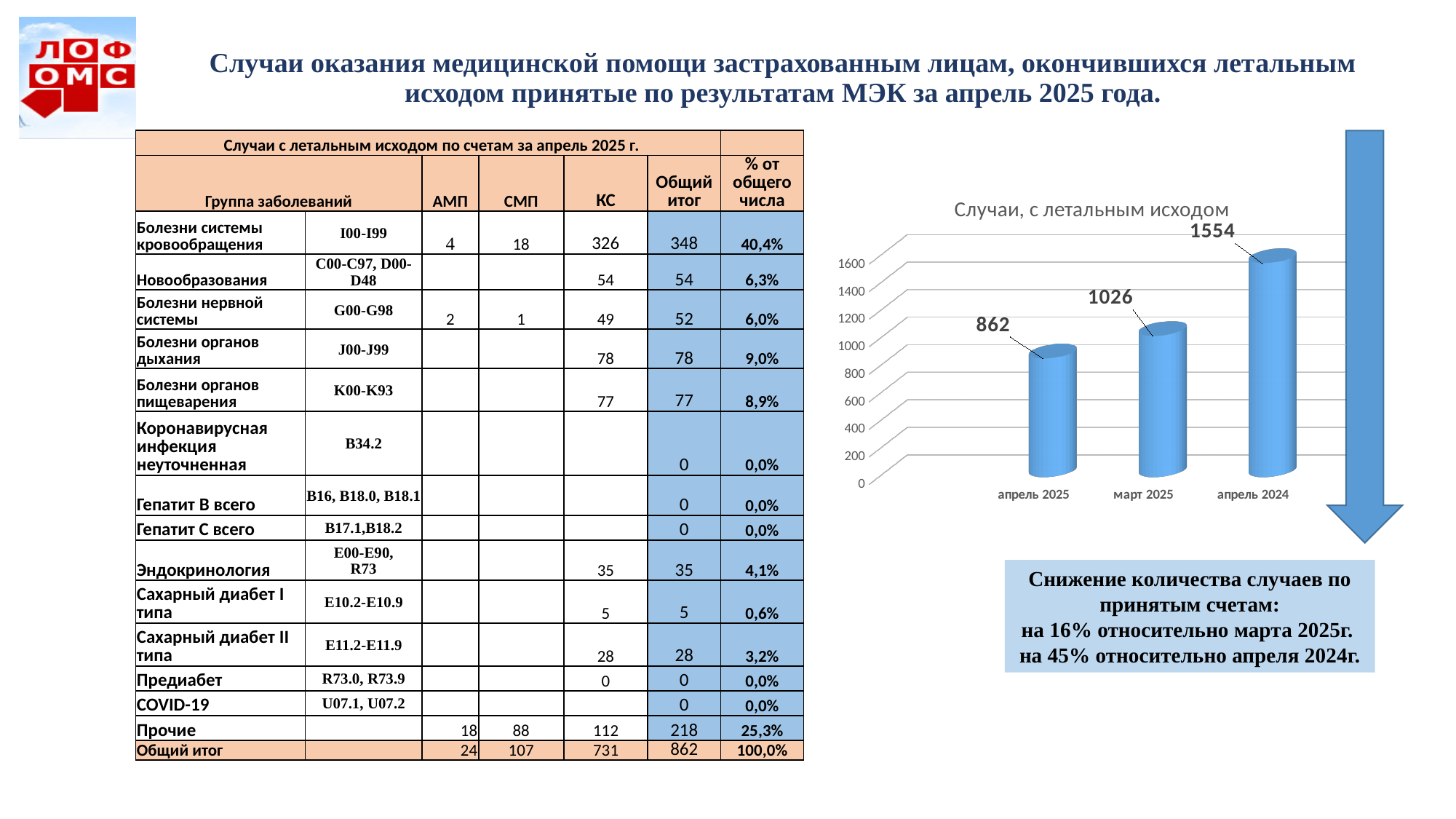
What is the value for апрель 2024 in the chart? 1554 Which is larger, the value for март 2025 or the value for апрель 2025? март 2025 What is the value for апрель 2025 in the chart? 862 Which period has the highest value in the chart? апрель 2024 Which period has the lowest value in the chart? апрель 2025 What is the difference between the values for апрель 2024 and апрель 2025? 692 What is the difference between the values for март 2025 and апрель 2025? 164 What is the title of the chart? Случаи, с летальным исходом What is the value for март 2025 in the chart? 1026 How many periods (bars) are shown in the chart? 3 Is the value for апрель 2024 greater or less than 1400? greater What kind of chart is shown on the slide? bar chart